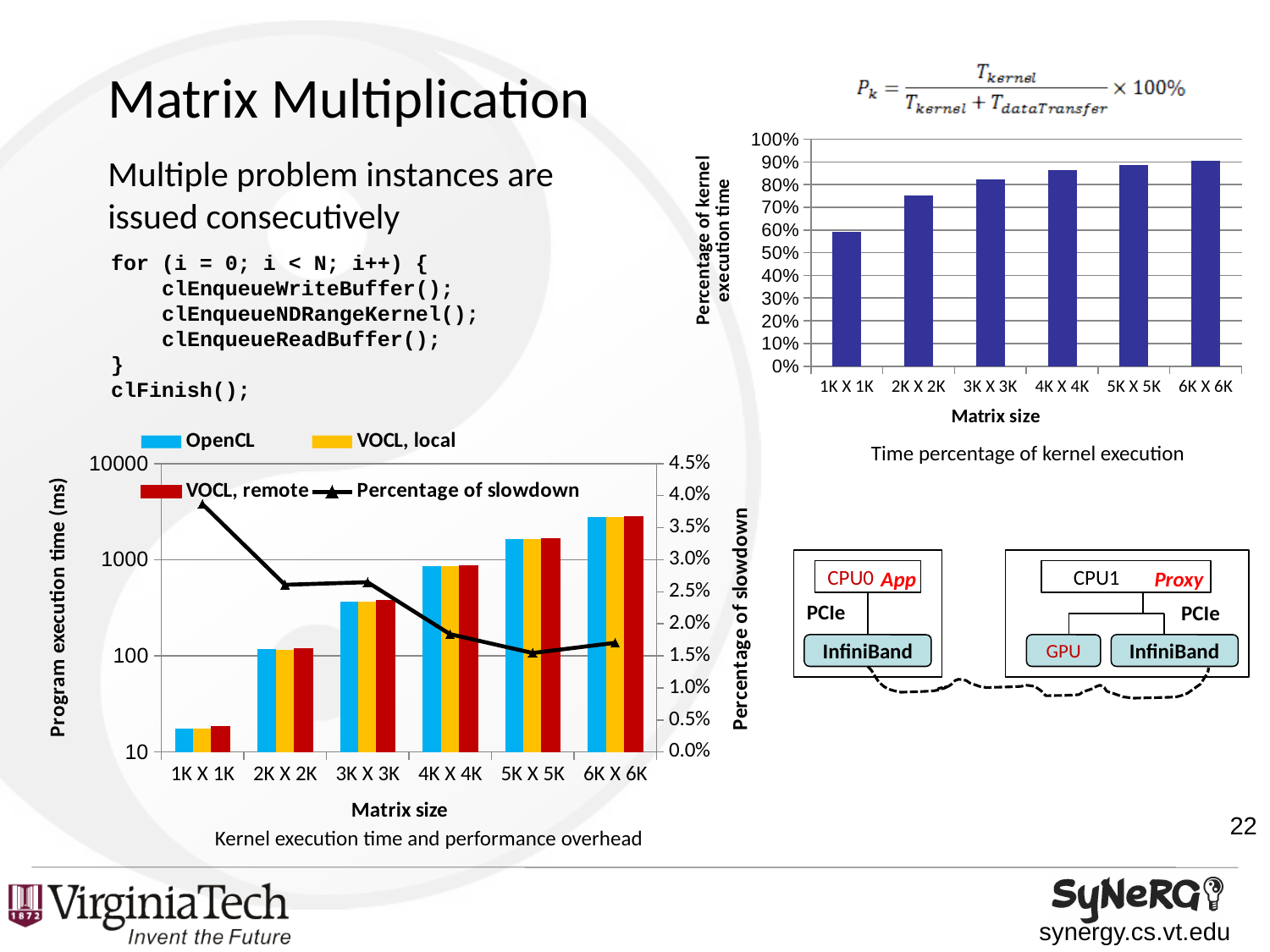
How many series does the legend of the 'Kernel execution time and performance overhead' chart list? 4 In the 'Kernel execution time and performance overhead' chart, at which matrix size is the percentage of slowdown highest? 1K X 1K In the 'Time percentage of kernel execution' chart, is the value for 2K X 2K greater or less than 70%? greater In the 'Time percentage of kernel execution' chart, which matrix size has the highest percentage of kernel execution time? 6K X 6K In the 'Time percentage of kernel execution' chart, is the value for 1K X 1K greater or less than 50%? greater In the 'Kernel execution time and performance overhead' chart, is the percentage of slowdown for 2K X 2K greater or less than 3.0%? less In the 'Time percentage of kernel execution' chart, does the percentage of kernel execution time rise or fall as the matrix size increases? rise In the 'Kernel execution time and performance overhead' chart, what is the label of the left vertical axis? Program execution time (ms) What kind of chart is the 'Time percentage of kernel execution' chart? bar chart In the 'Time percentage of kernel execution' chart, which matrix size has the lowest percentage of kernel execution time? 1K X 1K How many matrix sizes are shown in the 'Time percentage of kernel execution' chart? 6